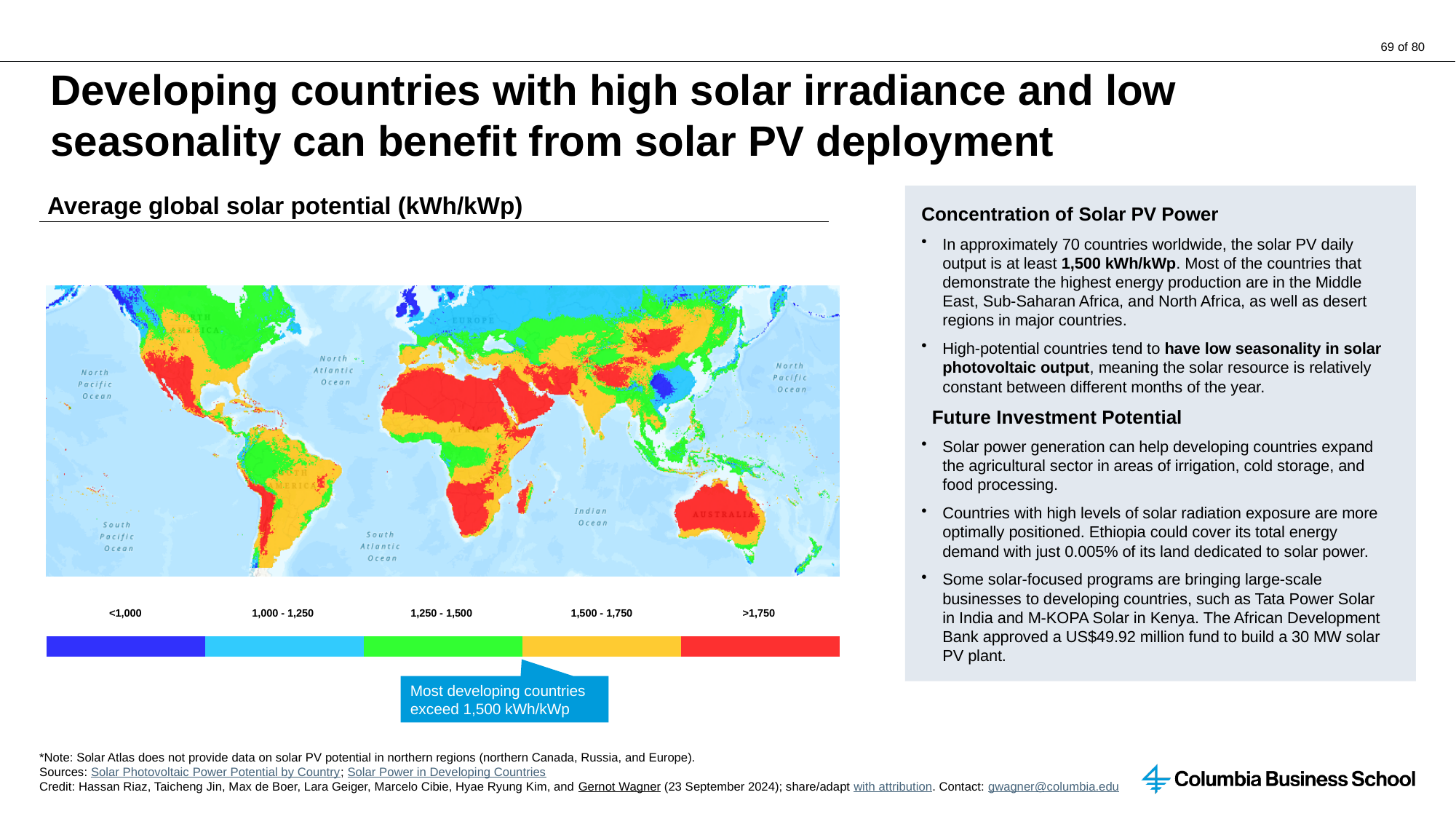
What value range does the yellow colour represent in the map legend? 1,500 - 1,750 In what unit is the solar potential on the map measured? kWh/kWp Which legend range is the lowest solar potential category on the map? <1,000 What value range does the dark blue colour represent in the map legend? <1,000 What kind of chart is shown on the slide? A map (world heat map) What value range does the red colour represent in the map legend? >1,750 Which legend range is the highest solar potential category on the map? >1,750 According to the callout below the legend, what value do most developing countries exceed? 1,500 kWh/kWp What value range does the light blue colour represent in the map legend? 1,000 - 1,250 How many value ranges does the map's colour legend list? 5 What value range does the green colour represent in the map legend? 1,250 - 1,500 What is the title of the map chart? Average global solar potential (kWh/kWp)